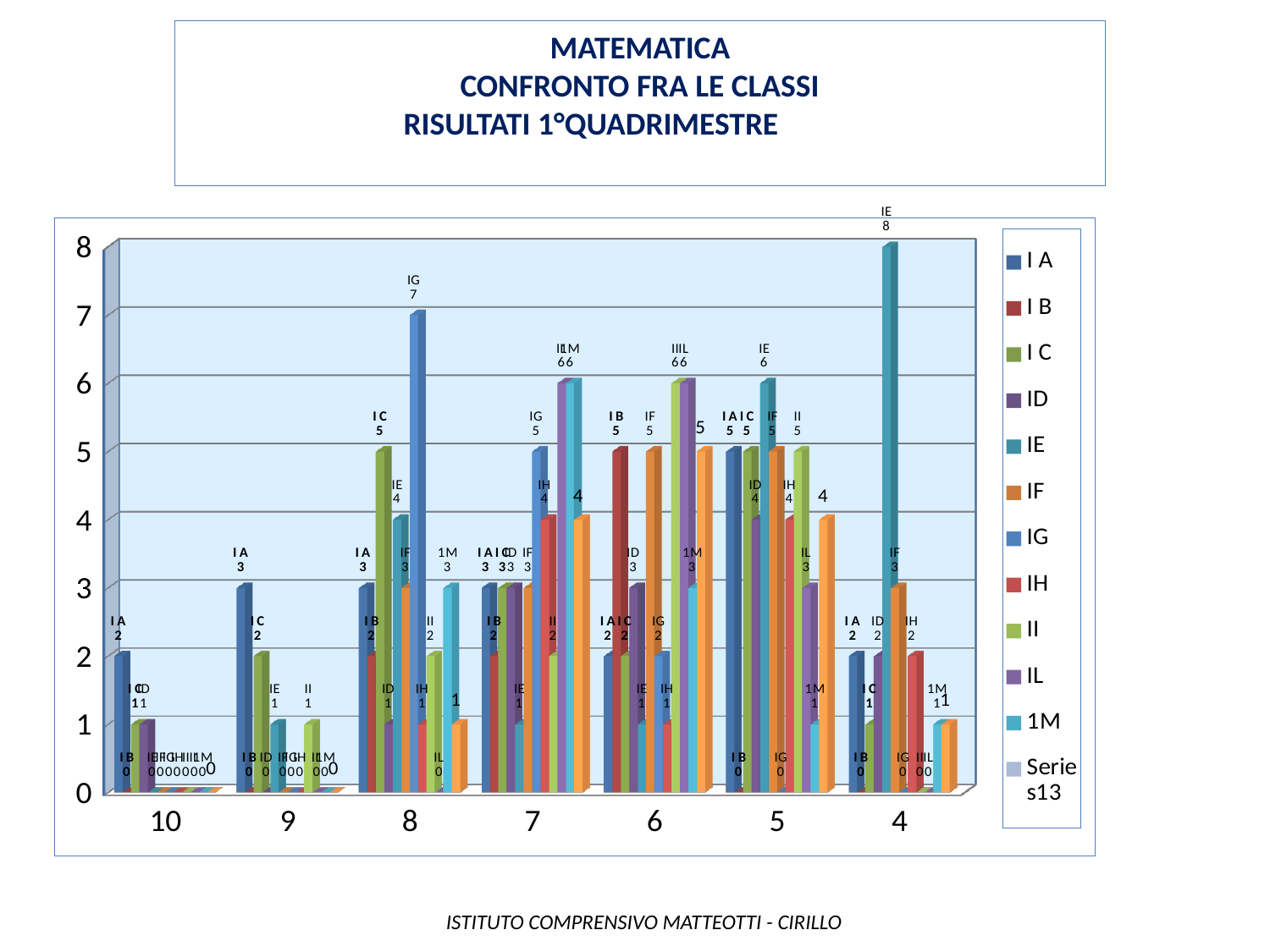
What is the value for IE at category 4? 8 Is the value for IE at category 4 greater or less than 6? greater What is the value for IE at category 5? 6 How many series does the legend list? 12 Which is larger: the I B value at category 6 or the I B value at category 8? I B at category 6 What is the value for I C at category 8? 5 What is the difference between the IG value and the I A value at category 8? 4 What is the value for I A at category 9? 3 Which series has the highest bar in the whole chart? IE Within category 8, which series has the highest value? IG How many categories are shown on the x axis? 7 What is the value for IG at category 8? 7